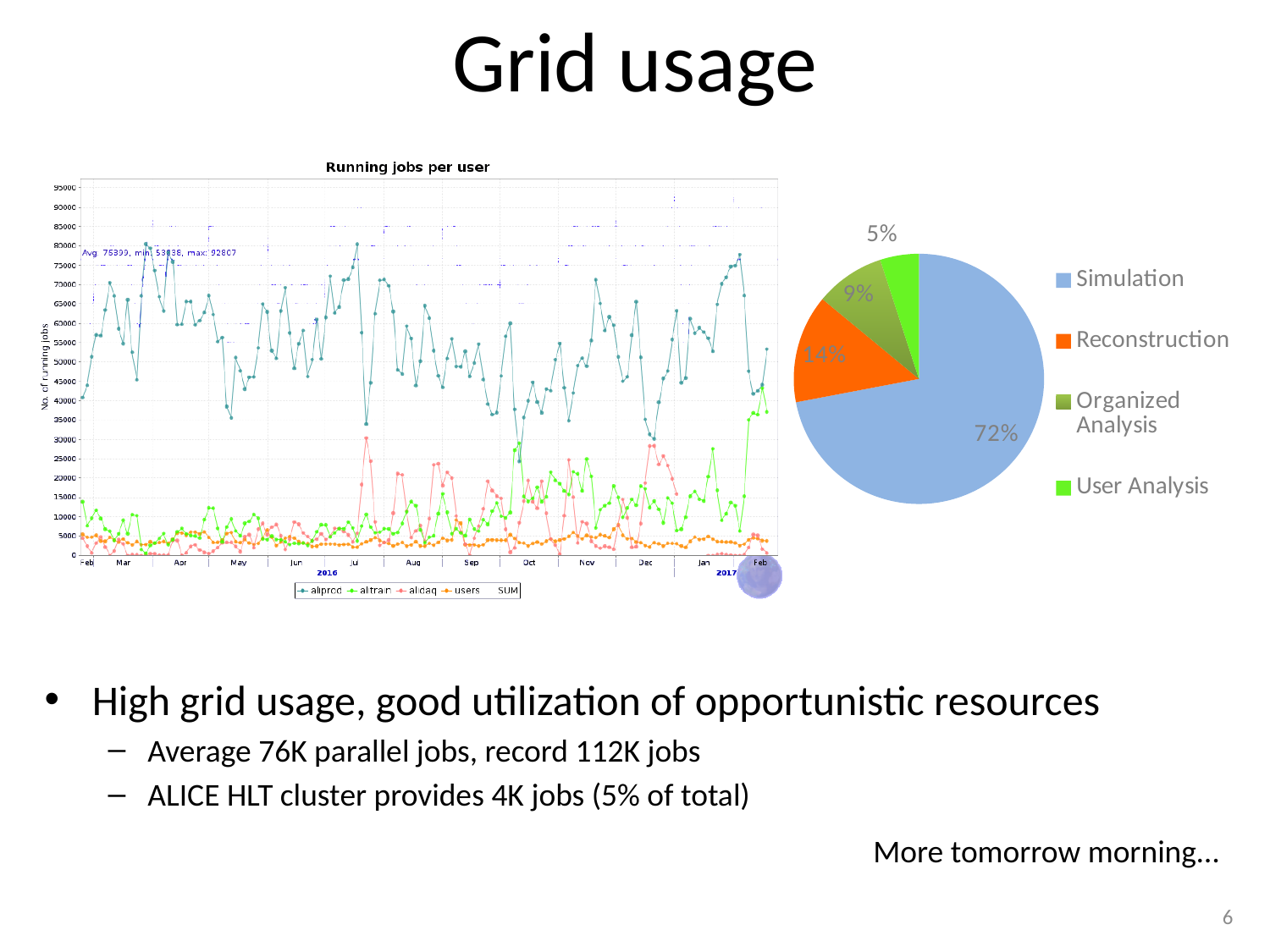
How many categories does the pie chart's legend list? 4 In the pie chart, which category has the largest slice? Simulation In the pie chart, what share does Reconstruction have? 14% In the pie chart, what is the difference in percentage points between Simulation and Reconstruction? 58 In the pie chart, which is larger, Organized Analysis or User Analysis? Organized Analysis What kind of chart is the chart on the right of the slide? Pie chart How many series does the legend of the 'Running jobs per user' chart list? 5 In the pie chart, which category has the smallest slice? User Analysis In the pie chart, what share does Organized Analysis have? 9% What kind of chart is the 'Running jobs per user' chart? Line chart In the pie chart, what share does User Analysis have? 5% In the pie chart, what share does Simulation have? 72%